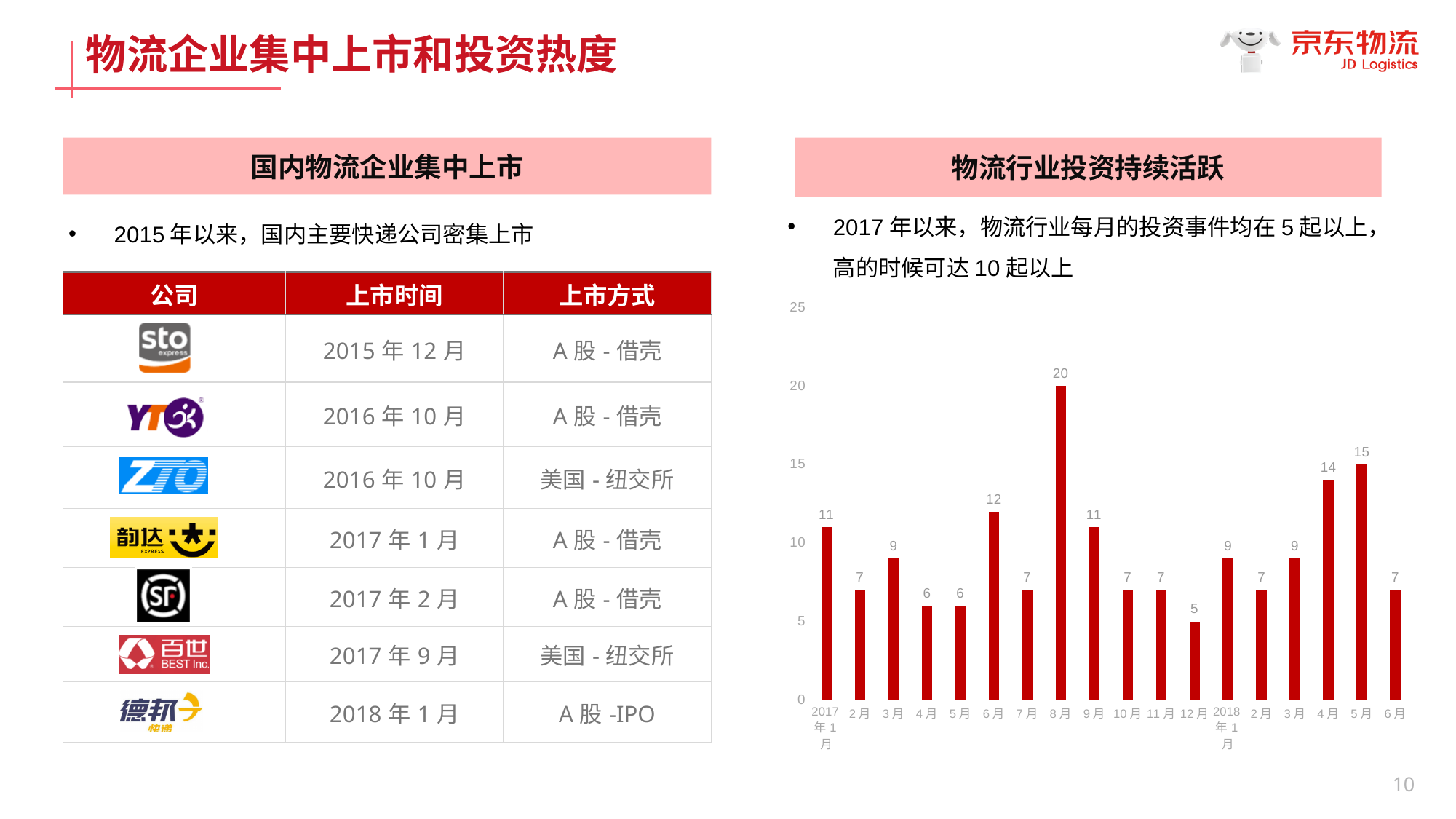
In the bar chart, what is the value for 2017年8月? 20 What type of chart is shown on the right side of the slide? bar chart In the bar chart, which is larger: the value for 2018年4月 or the value for 2017年9月? 2018年4月 In the bar chart, what is the value for 2017年12月? 5 In the bar chart, what is the value for 2017年6月? 12 In the bar chart, what is the value for 2018年5月? 15 In the bar chart, what is the difference between the values for 2018年4月 and 2018年1月? 5 Which month has the highest value in the bar chart? 2017年8月 Which month has the lowest value in the bar chart? 2017年12月 In the bar chart, what is the difference between the values for 2017年8月 and 2018年5月? 5 What is the maximum value shown on the vertical axis of the bar chart? 25 How many bars (months) are plotted in the bar chart? 18